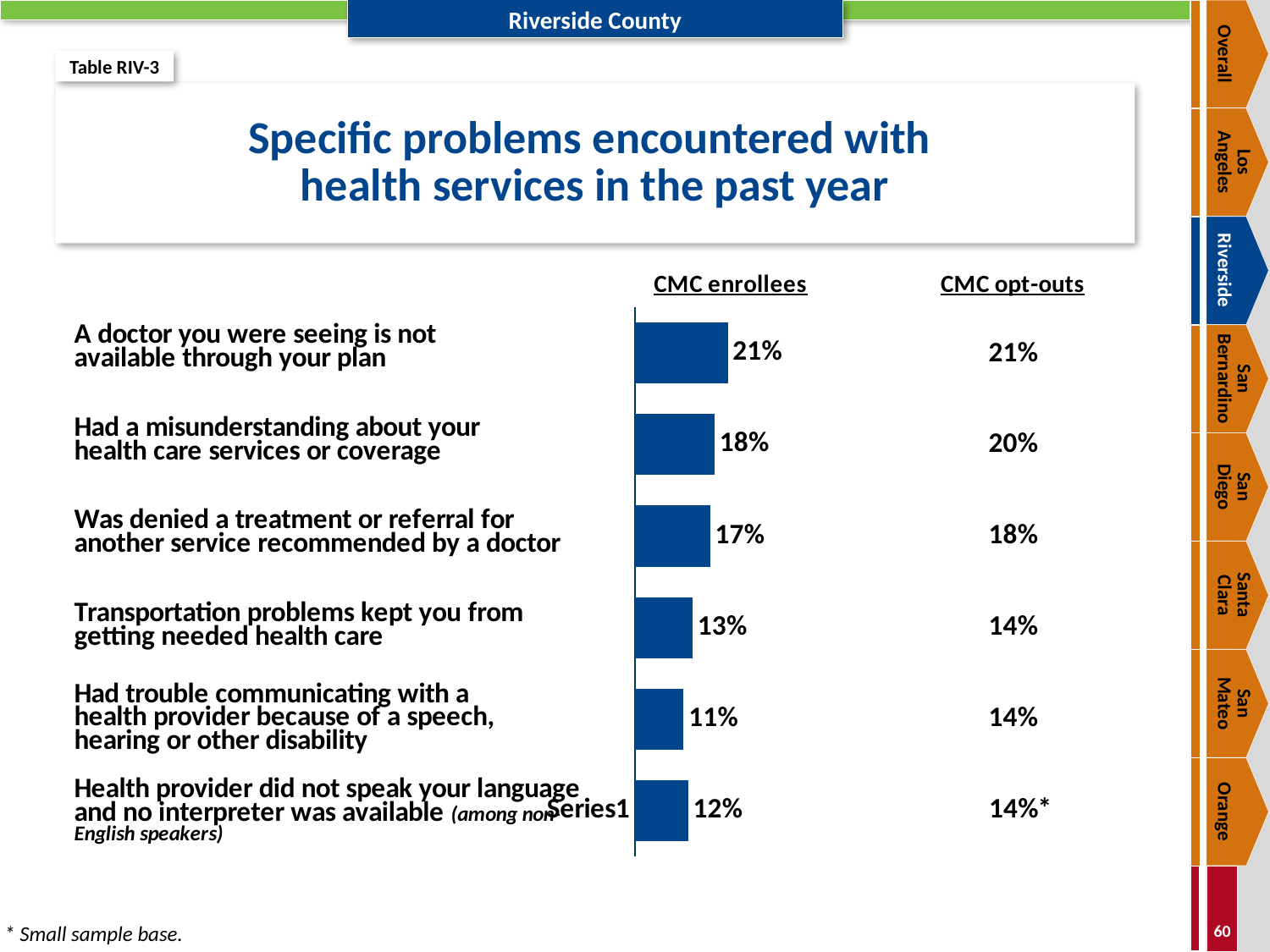
What is the CMC enrollees value for "A doctor you were seeing is not available through your plan"? 21% Which problem has the highest CMC enrollees value in the chart? A doctor you were seeing is not available through your plan Among CMC enrollees, which is larger: the value for transportation problems or the value for the health provider not speaking your language? Transportation problems What is the CMC enrollees value for "Health provider did not speak your language and no interpreter was available"? 12% How many problem categories are plotted as bars in the chart? 6 What is the CMC enrollees value for "Had a misunderstanding about your health care services or coverage"? 18% What is the title of the chart? Specific problems encountered with health services in the past year What is the CMC enrollees value for "Transportation problems kept you from getting needed health care"? 13% What is the difference in percentage points between the highest and lowest CMC enrollees values in the chart? 10 What kind of chart is shown on the slide? bar chart Which problem has the lowest CMC enrollees value in the chart? Had trouble communicating with a health provider because of a speech, hearing or other disability What is the CMC enrollees value for "Was denied a treatment or referral for another service recommended by a doctor"? 17%